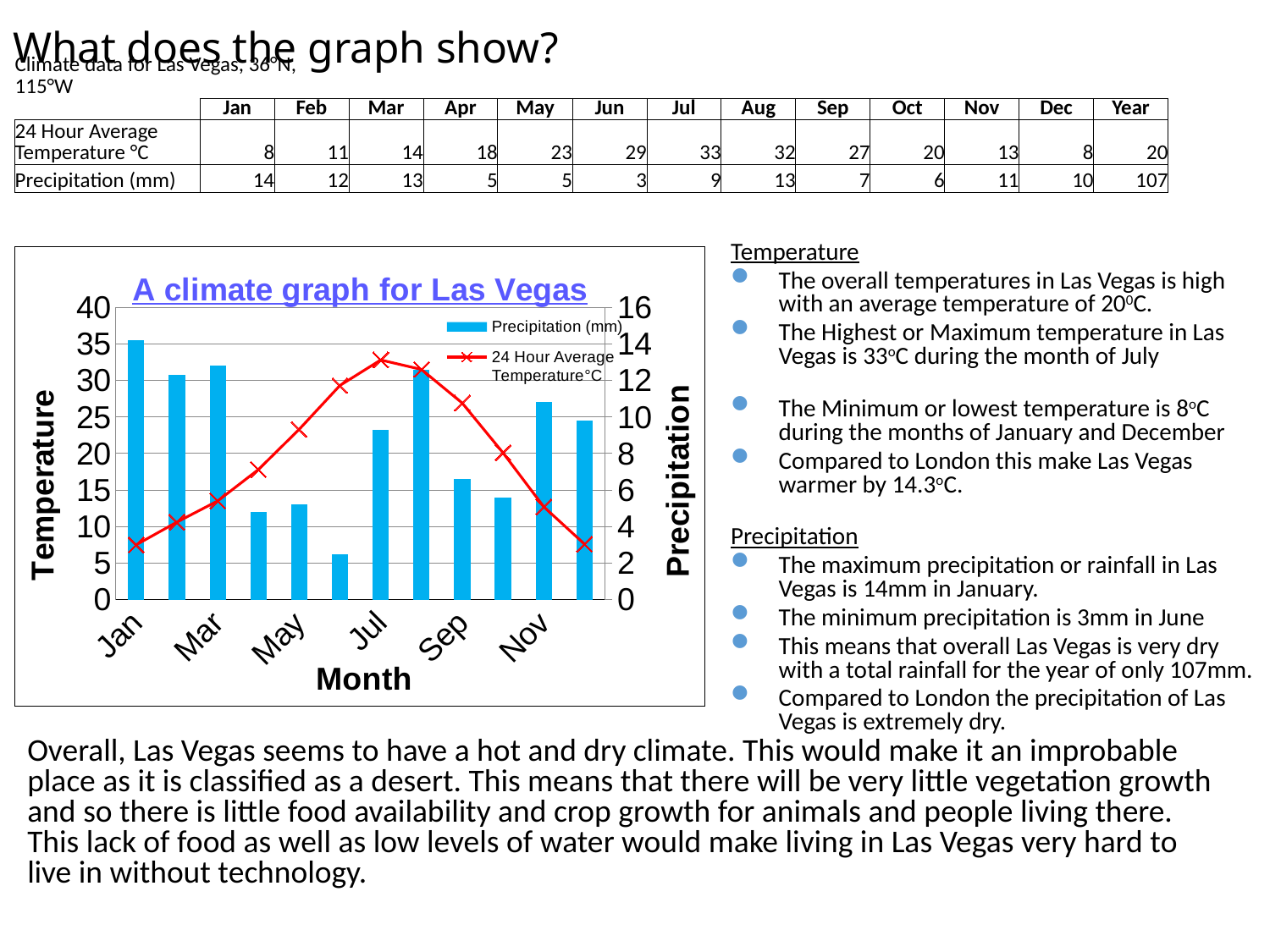
Which month has the highest precipitation bar in the climate graph? Jan What is the precipitation value for Aug in the climate graph? 13 Is the 24 Hour Average Temperature for Jun greater or less than 25? greater What is the difference between the precipitation for Jan and the precipitation for Jun? 11 What is the 24 Hour Average Temperature for May in the climate graph? 23 How many months are plotted along the x axis of the climate graph? 12 Which month has the lowest precipitation bar in the climate graph? Jun In which month does the 24 Hour Average Temperature line reach its highest point? Jul How many series does the legend of the climate graph list? 2 What kind of chart is 'A climate graph for Las Vegas'? A combined bar and line chart Does the 24 Hour Average Temperature line rise or fall from Jan to Jul? rise Which month has the larger precipitation bar, Mar or Sep? Mar